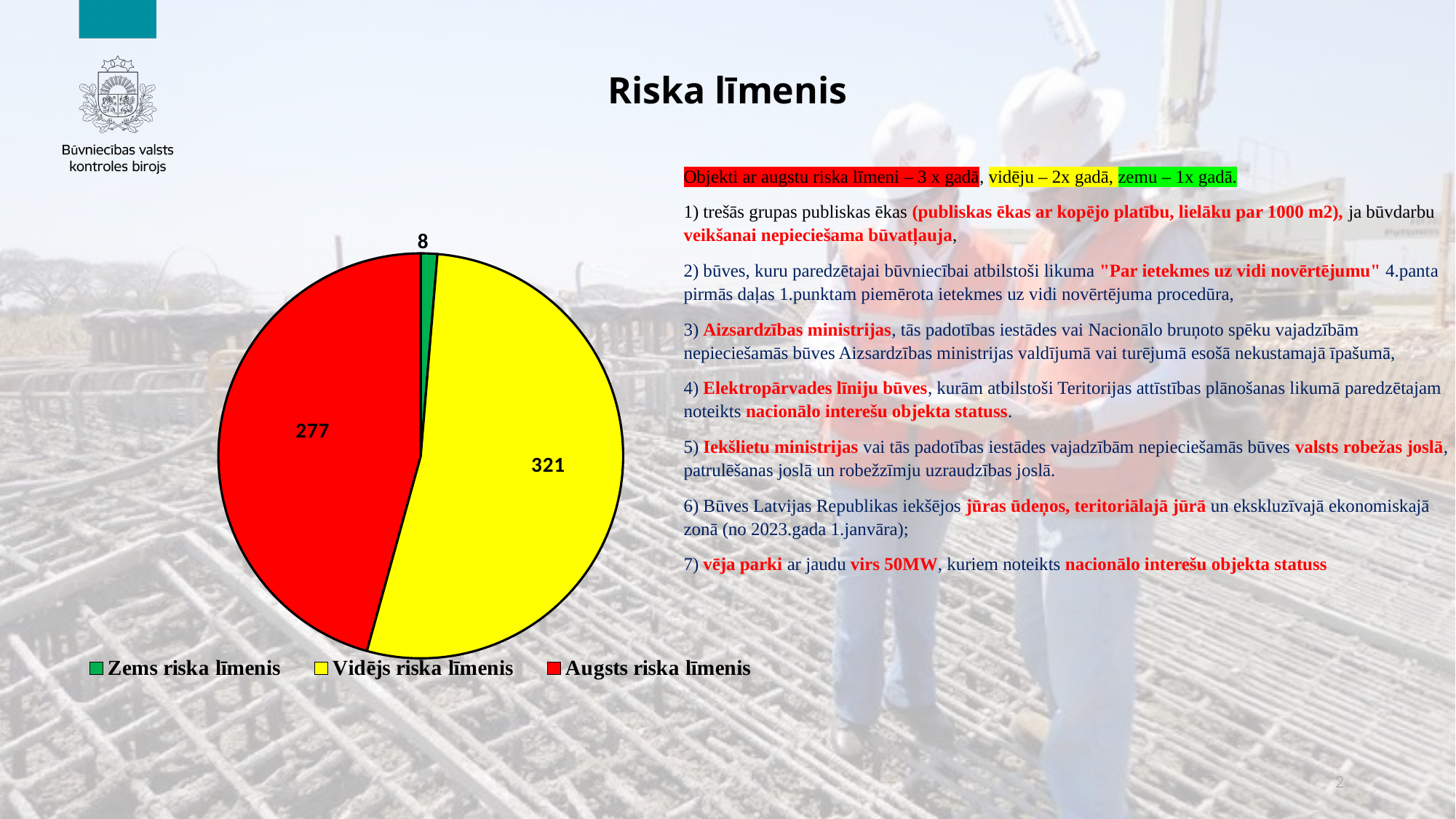
Which category has the smallest slice in the pie chart? Zems riska līmenis What colour is the slice for Augsts riska līmenis? red What is the value for Vidējs riska līmenis in the pie chart? 321 What type of chart is shown on the slide? pie chart What share of the pie does Vidējs riska līmenis represent, to the nearest whole percent? 53% What is the value for Augsts riska līmenis in the pie chart? 277 What is the value for Zems riska līmenis in the pie chart? 8 Which category has the largest slice in the pie chart? Vidējs riska līmenis What is the total of all slices in the pie chart? 606 What is the difference between the values for Vidējs riska līmenis and Augsts riska līmenis? 44 Which is larger, the value for Augsts riska līmenis or the value for Zems riska līmenis? Augsts riska līmenis How many categories does the pie chart show? 3